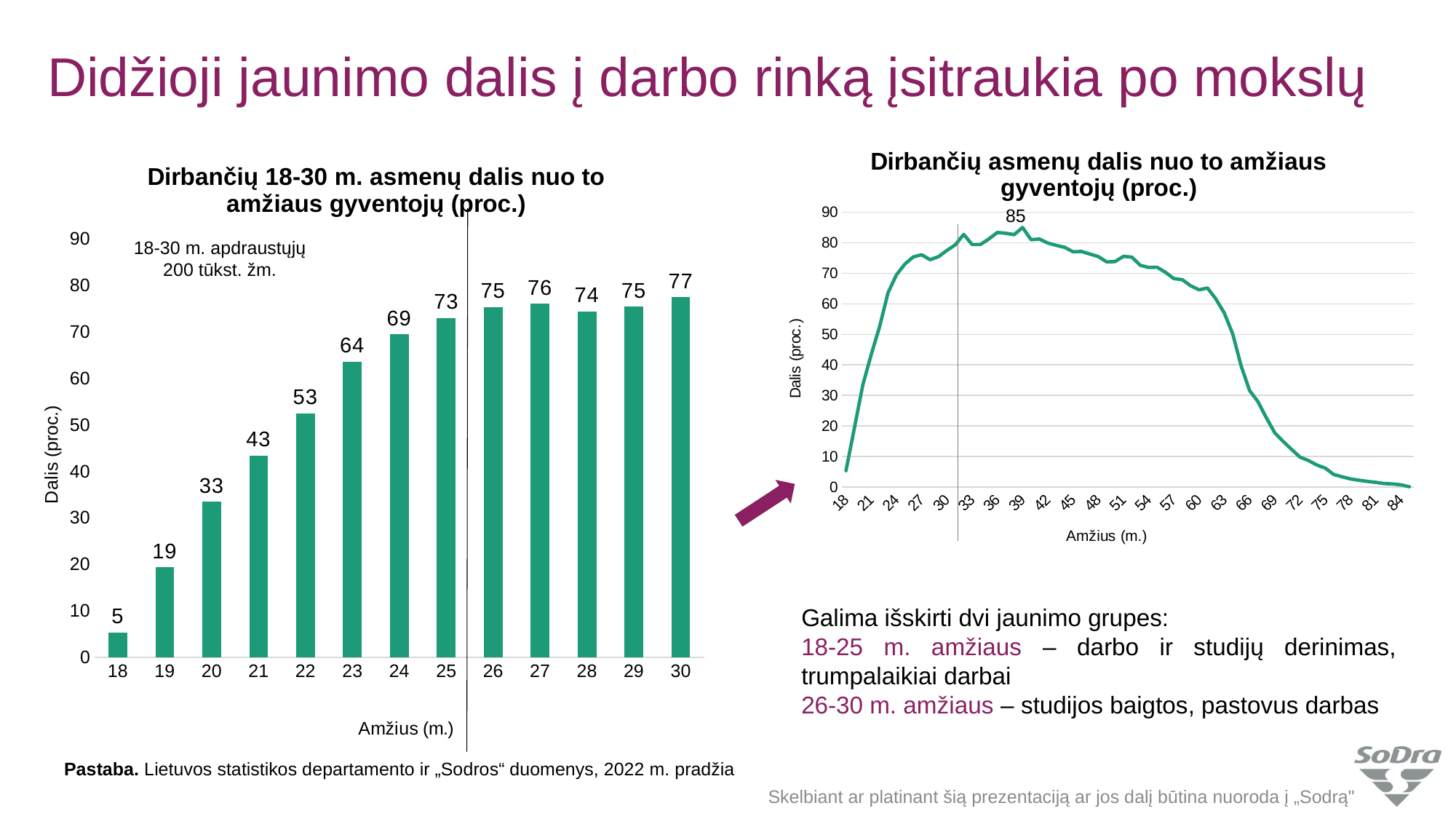
In the left bar chart, which age has the lowest value? 18 How many age categories are shown in the left bar chart? 13 What kind of chart is the left chart titled 'Dirbančių 18-30 m. asmenų dalis nuo to amžiaus gyventojų (proc.)'? bar chart In the left bar chart, which age has the highest value? 30 In the right line chart, is the value for age 66 greater or less than 40? less What kind of chart is the right chart titled 'Dirbančių asmenų dalis nuo to amžiaus gyventojų (proc.)'? line chart In the left bar chart, which is larger, the value for age 27 or the value for age 28? 27 In the left bar chart, what is the value for age 18? 5 In the left bar chart, what is the value for age 23? 64 In the left bar chart, do the values generally rise or fall from age 18 to age 25? rise In the right line chart, what is the peak value labelled on the line? 85 In the left bar chart, what is the difference between the values for age 22 and age 19? 34